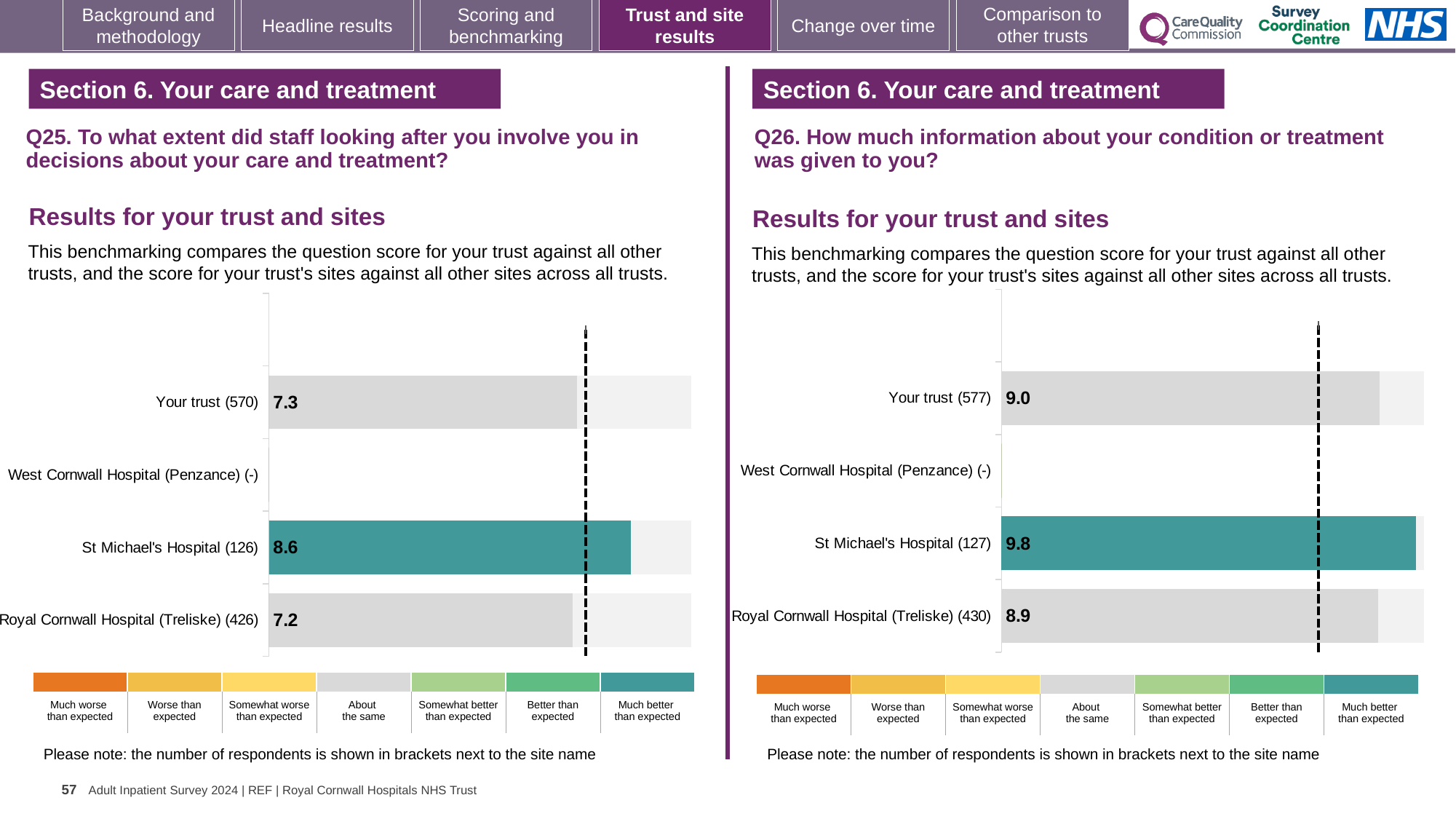
In the Q26 chart on the right, what is the score for St Michael's Hospital (127)? 9.8 In the Q25 chart on the left, what is the score for Your trust (570)? 7.3 In the Q25 chart on the left, which site has the highest score? St Michael's Hospital (126) In the Q25 chart on the left, what is the difference between the scores for St Michael's Hospital and Royal Cornwall Hospital (Treliske)? 1.4 In the Q26 chart on the right, which site has the lowest score among those with a plotted bar? Royal Cornwall Hospital (Treliske) (430) In the Q25 chart on the left, what is the score for St Michael's Hospital (126)? 8.6 In the Q26 chart on the right, what is the score for Your trust (577)? 9.0 In the Q25 chart on the left, what is the score for Royal Cornwall Hospital (Treliske) (426)? 7.2 In the Q26 chart on the right, what is the difference between the scores for St Michael's Hospital and Your trust? 0.8 In the Q26 chart on the right, what is the score for Royal Cornwall Hospital (Treliske) (430)? 8.9 In the Q25 chart on the left, which has the larger score: Your trust or Royal Cornwall Hospital (Treliske)? Your trust What type of chart is used in the Q26 chart on the right? Bar chart